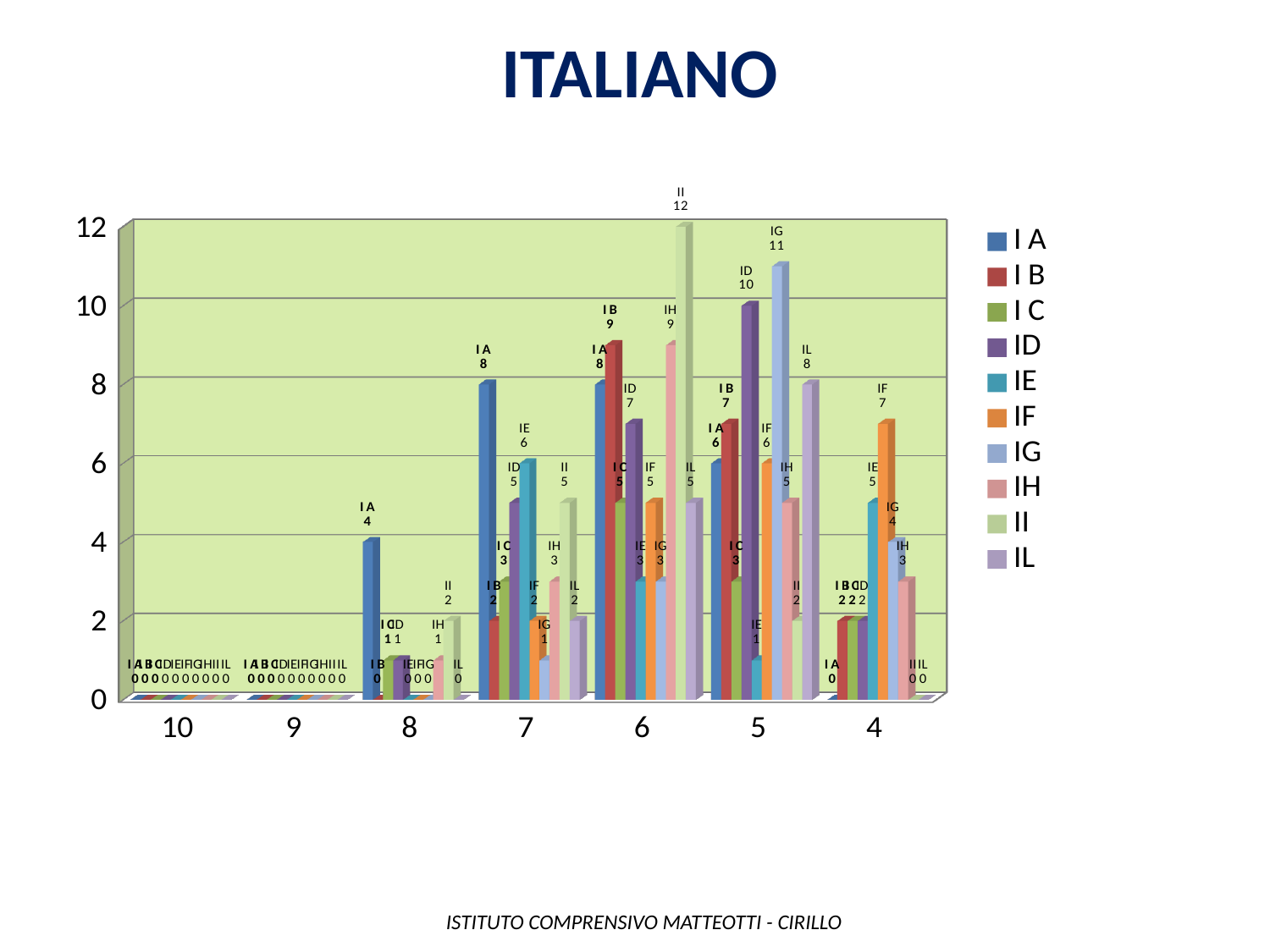
How many series does the legend list? 10 What is the value for series I A at category 8? 4 What is the value for series IG at category 5? 11 What kind of chart is shown on the slide? bar chart Which series has the highest value at category 5? IG What is the title of the chart? ITALIANO Which series has the highest value at category 6? II What is the value for series IF at category 4? 7 What is the value for series II at category 6? 12 At category 7, which is larger: the value for I A or the value for IE? I A What is the difference between the values of IG and ID at category 5? 1 How many categories are shown on the x axis? 7